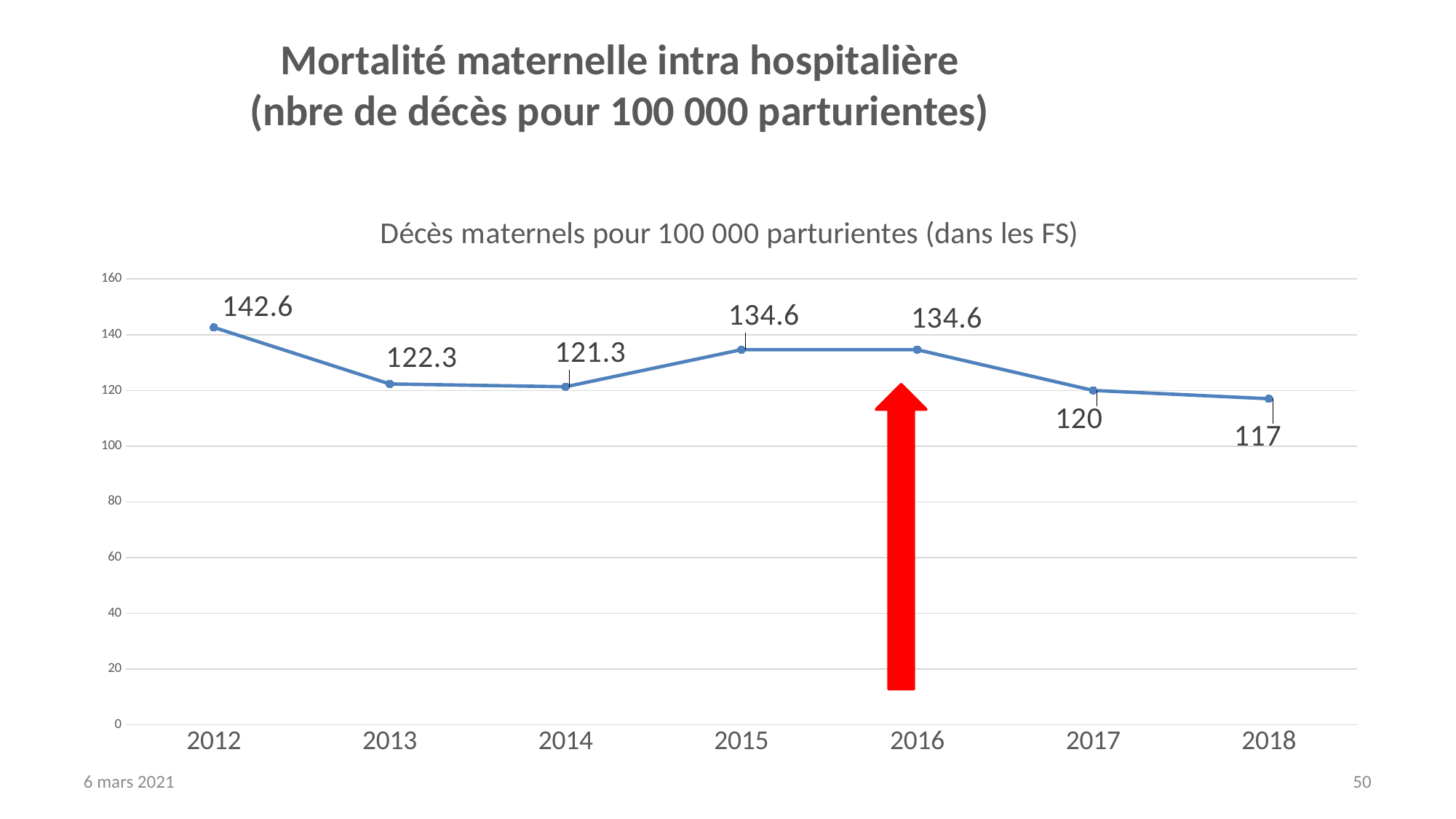
What is the value for 2012? 142.6 What is the difference between the values for 2012 and 2018? 25.6 Which year has the highest value? 2012 What kind of chart is shown? line chart What is the value for 2014? 121.3 Which is larger, the value for 2013 or the value for 2015? 2015 Is the value for 2017 greater or less than 140? less What is the title of the chart? Décès maternels pour 100 000 parturientes (dans les FS) What is the value for 2018? 117 Which year has the lowest value? 2018 Do the values rise or fall from 2016 to 2018? fall How many years are plotted on the chart? 7